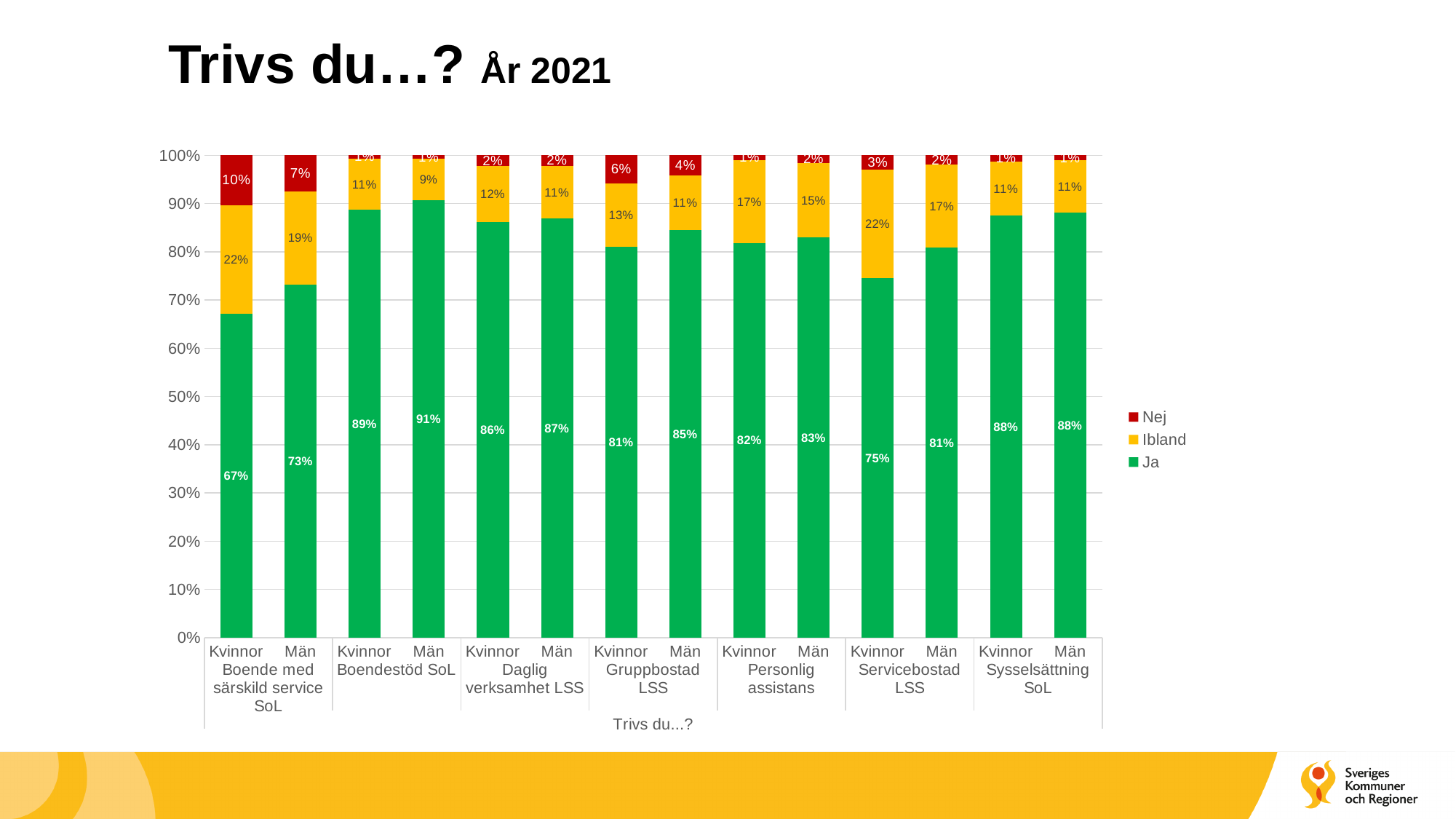
Which bar has the lowest Ja share? Kvinnor, Boende med särskild service SoL (67%) What is the Ibland share for Män in Servicebostad LSS? 17% What is the difference in the Ja share between Män and Kvinnor in Servicebostad LSS? 6 percentage points How many bars are shown in the chart? 14 Which bar has the highest Ja share? Män, Boendestöd SoL (91%) How many series does the legend list? 3 What percentage of Kvinnor in Boende med särskild service SoL answered Ja? 67% Is the Ja share for Kvinnor in Servicebostad LSS greater or less than 80%? less Which has a larger Nej share: Kvinnor in Boende med särskild service SoL or Kvinnor in Gruppbostad LSS? Kvinnor in Boende med särskild service SoL What is the Nej share for Kvinnor in Gruppbostad LSS? 6% What type of chart is shown on the slide? Stacked bar chart Which colour represents the Ibland answer in the chart? Yellow